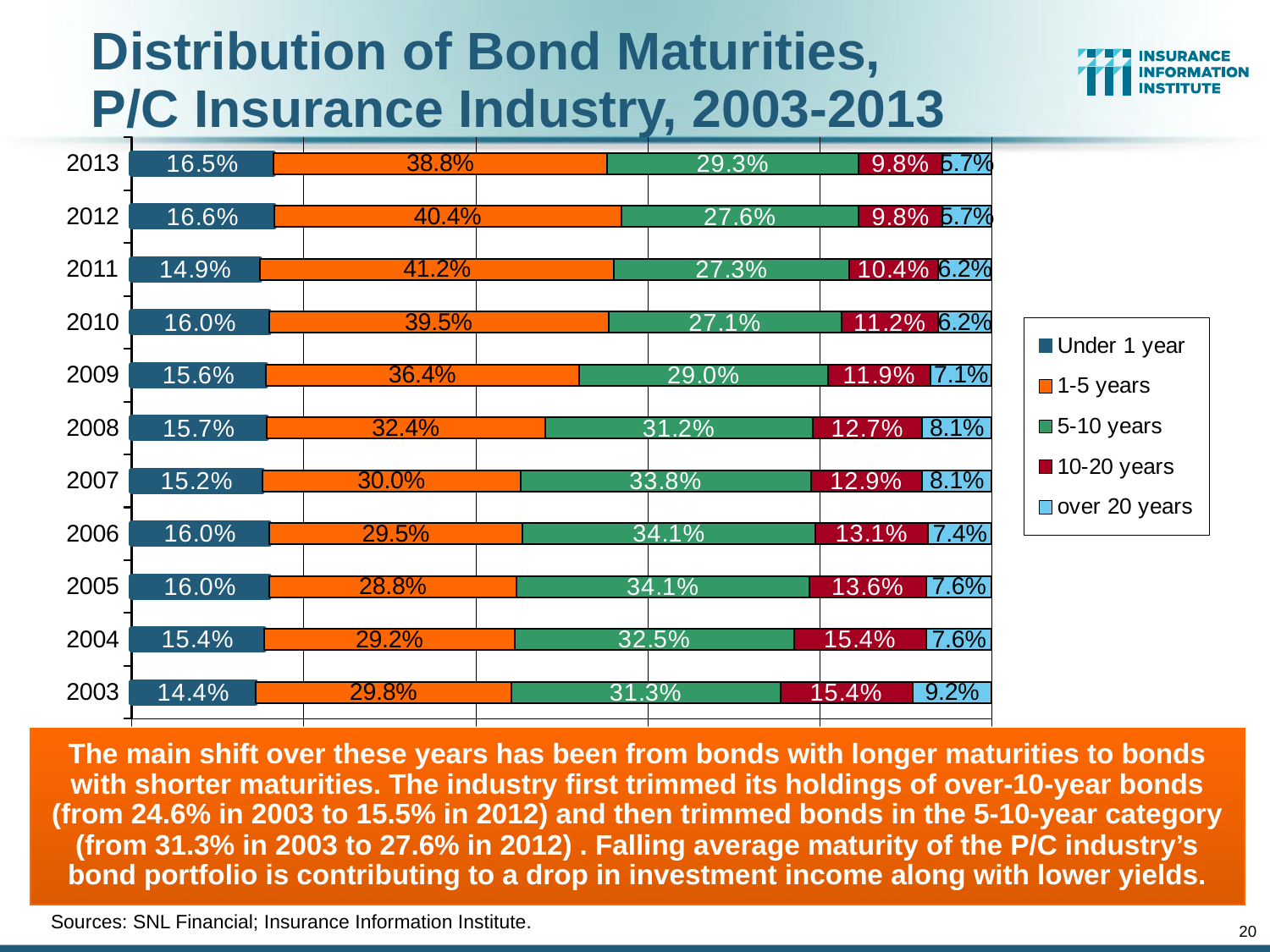
What share of bonds had a 10-20 year maturity in 2009? 11.9% What is the difference between the 5-10 years share in 2003 and in 2012? 3.7 percentage points What colour represents the 1-5 years series in the legend? Orange What share of bonds had a 1-5 year maturity in 2013? 38.8% How many years are shown on the chart? 11 What kind of chart is shown on the slide? Stacked bar chart In which year was the Under 1 year share the lowest? 2003 How many series does the legend list? 5 What share of bonds had an over 20 years maturity in 2003? 9.2% Which was larger in 2007: the 1-5 years share or the 5-10 years share? 5-10 years In which year was the 1-5 years share the highest? 2011 How did the over 20 years share change from 2003 to 2013? It fell